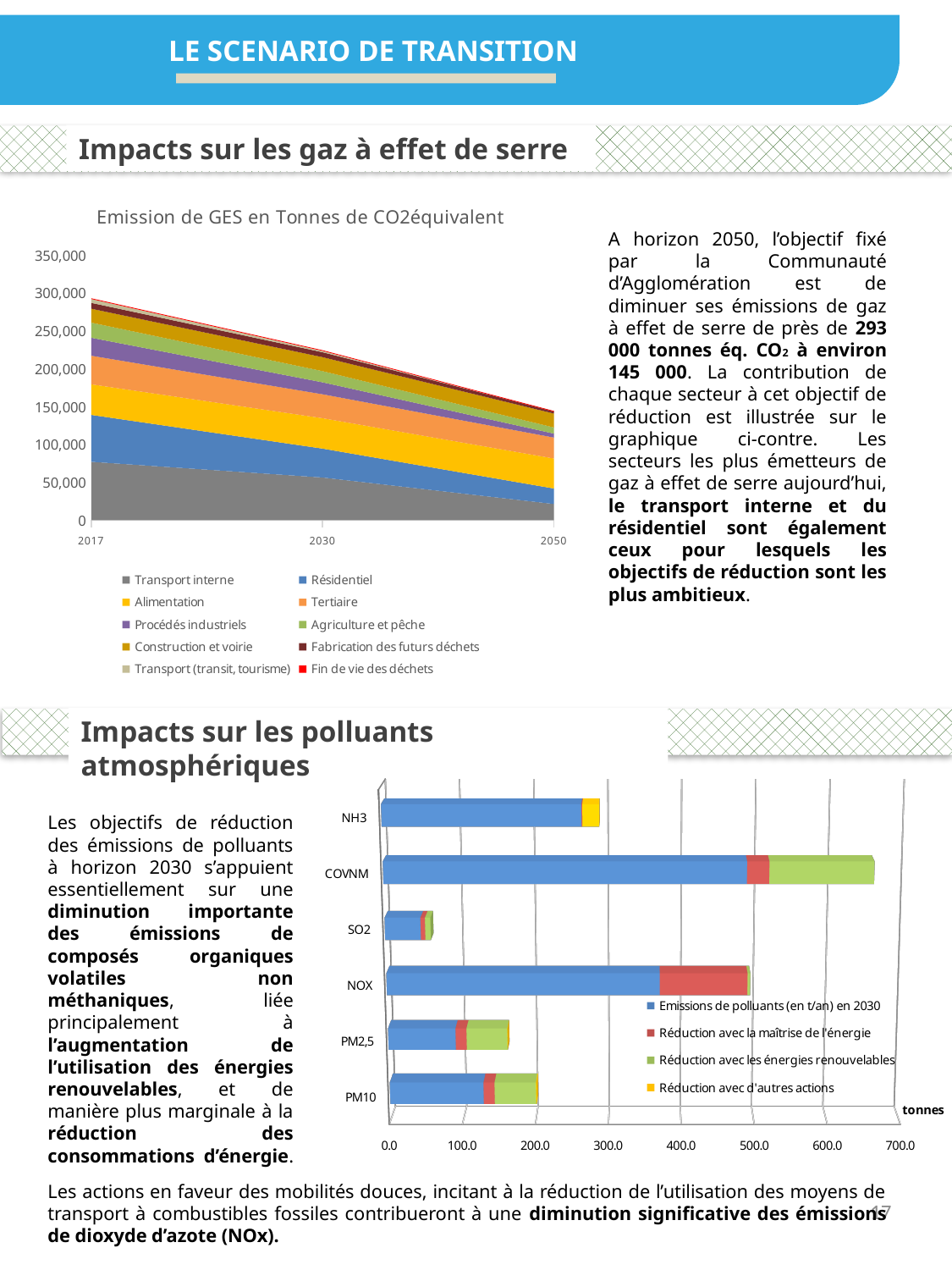
In the top chart 'Emission de GES en Tonnes de CO2équivalent', is the total stacked value in 2017 greater or less than 250,000? greater In the bottom pollutant chart, how many pollutant categories are shown on the vertical axis? 6 In the top chart 'Emission de GES en Tonnes de CO2équivalent', how many series does the legend list? 10 In the bottom pollutant chart, is the total bar for COVNM greater or less than 600.0? greater What type of chart is the top chart titled 'Emission de GES en Tonnes de CO2équivalent'? stacked area chart In the top chart 'Emission de GES en Tonnes de CO2équivalent', which years are labelled on the x axis? 2017, 2030, 2050 In the bottom pollutant chart, how many series does the legend list? 4 In the top chart 'Emission de GES en Tonnes de CO2équivalent', is the value for Transport interne in 2017 greater or less than 50,000? greater In the bottom pollutant chart, which pollutant has the shortest total bar? SO2 In the top chart 'Emission de GES en Tonnes de CO2équivalent', do total emissions rise or fall from 2017 to 2050? fall In the bottom pollutant chart, which pollutant has the longest total bar? COVNM What type of chart is the bottom chart showing pollutant emissions (NH3, COVNM, SO2, NOX, PM2,5, PM10)? stacked bar chart